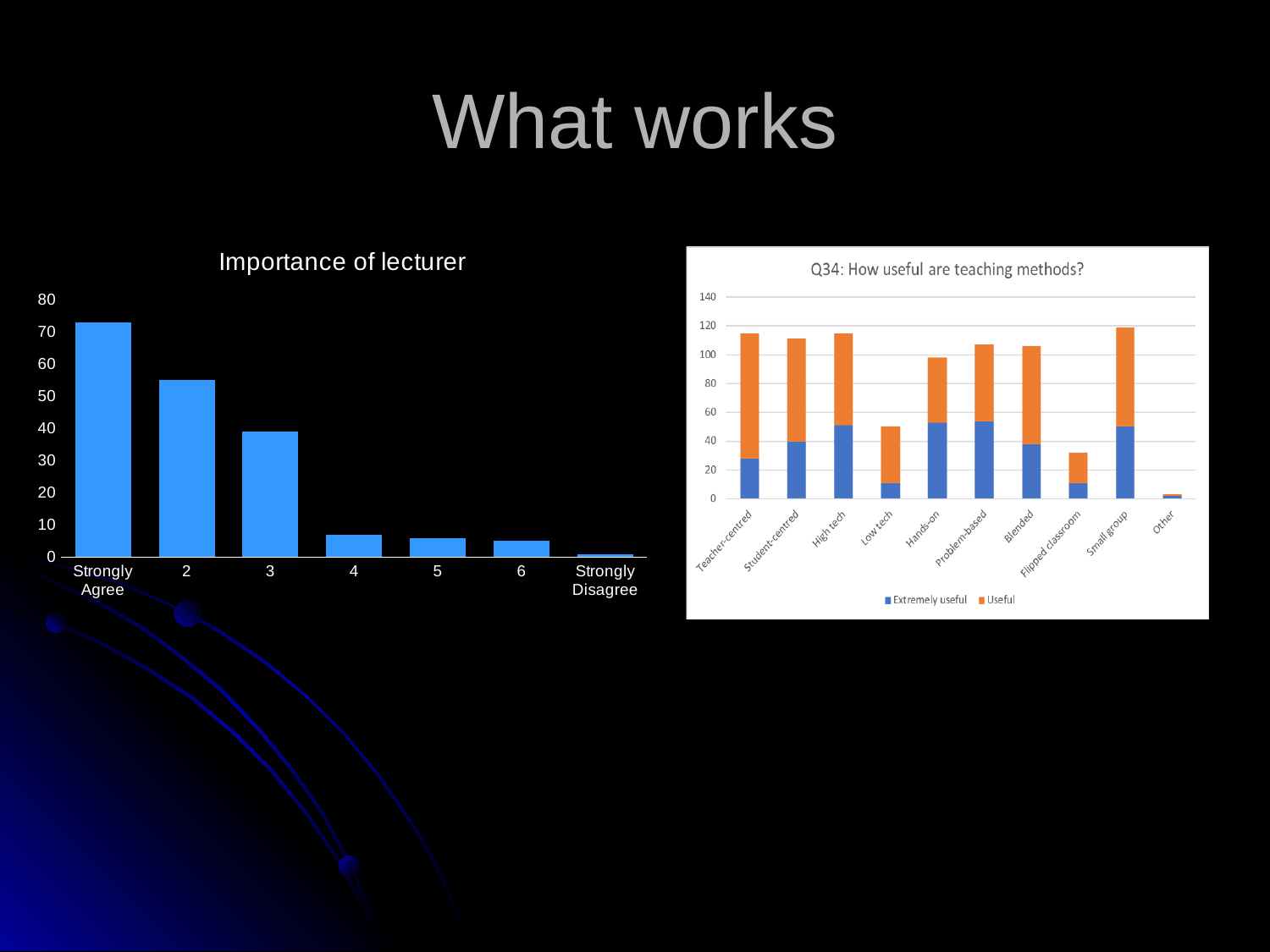
What type of chart is the 'Importance of lecturer' chart? bar chart In the 'Importance of lecturer' chart, is the value for Strongly Agree greater or less than 70? greater In the 'Q34: How useful are teaching methods?' chart, which teaching method has the lowest total? Other In the 'Importance of lecturer' chart, how many categories are shown on the x axis? 7 In the 'Q34: How useful are teaching methods?' chart, which has the larger total, Low tech or Hands-on? Hands-on In the 'Importance of lecturer' chart, do the values rise or fall from Strongly Agree to Strongly Disagree? fall In the 'Importance of lecturer' chart, which category has the lowest value? Strongly Disagree In the 'Importance of lecturer' chart, which category has the highest value? Strongly Agree In the 'Importance of lecturer' chart, is the value for category 4 greater or less than 10? less In the 'Q34: How useful are teaching methods?' chart, how many series does the legend list? 2 In the 'Q34: How useful are teaching methods?' chart, is the total for Teacher-centred greater or less than 100? greater In the 'Q34: How useful are teaching methods?' chart, how many teaching methods are shown on the x axis? 10